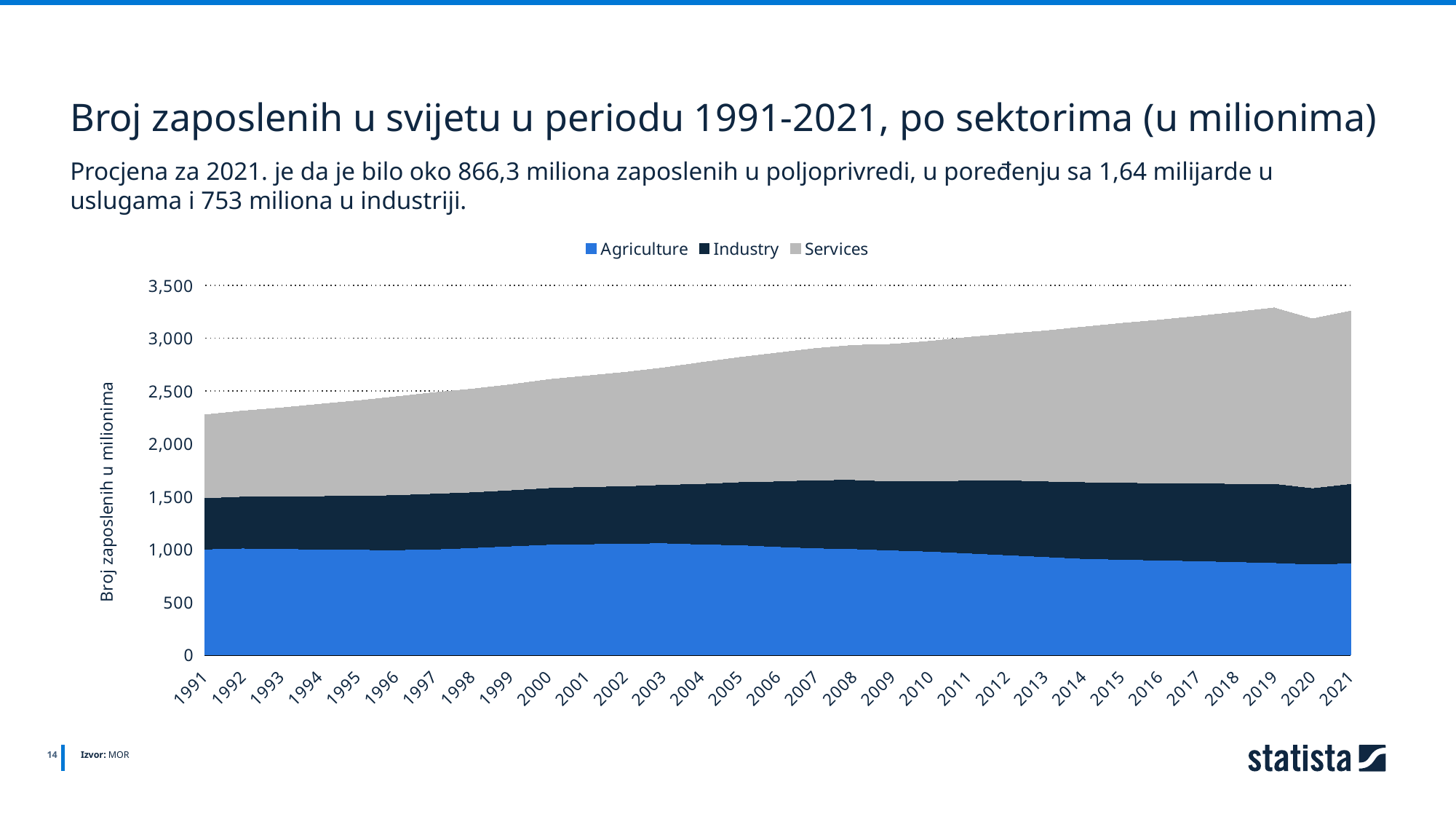
How many series does the legend list? 3 According to the slide text, how many people were employed in agriculture in 2021? 866,3 miliona In which year is the total employment across all sectors lowest? 1991 How many years are shown along the x axis? 31 Is the total employment (top of the stacked area) in 2021 greater or less than 3,000? greater Is the total employment (top of the stacked area) in 1991 greater or less than 2,500? less Is the Agriculture value in 2021 greater or less than 1,000? less Which series is shown in light blue? Agriculture Does the total employment across all sectors generally rise or fall from 1991 to 2021? rise What kind of chart is shown on the slide? stacked area chart Which sector has the largest number of employees in 2021? Services What is the label of the y axis? Broj zaposlenih u milionima